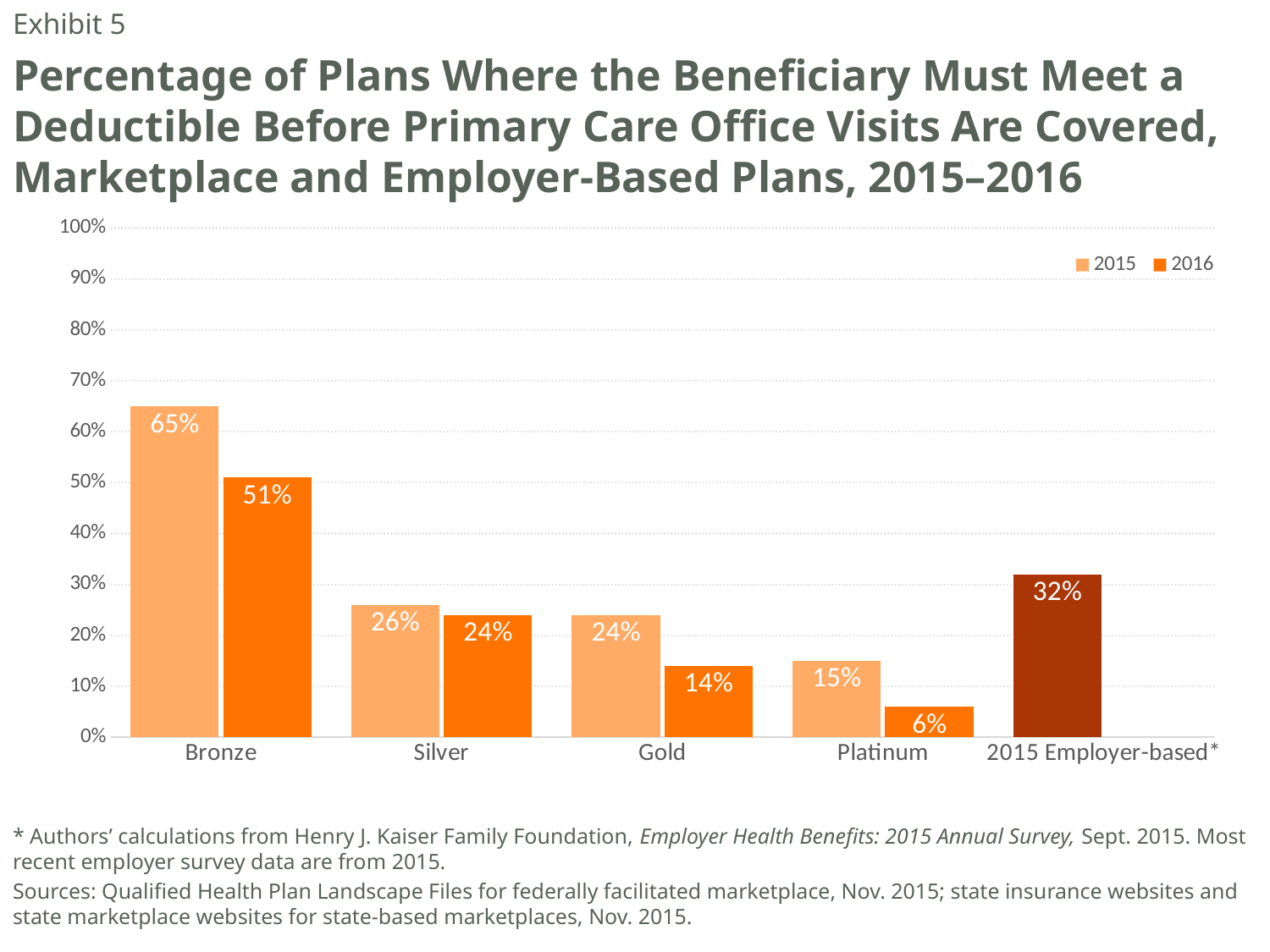
How many categories are shown on the x axis? 5 Which is larger: the 2016 value for Silver or the 2016 value for Gold? Silver Which metal tier has the highest 2016 value? Bronze What is the 2016 value for Platinum plans? 6% What is the 2015 value for Bronze plans? 65% What kind of chart is shown on the slide? Bar chart Do the 2016 values rise or fall from Bronze to Platinum? Fall Which metal tier has the lowest 2015 value? Platinum What is the value shown for 2015 Employer-based plans? 32% What is the difference between the 2015 and 2016 values for Bronze plans? 14% How many series does the legend list? 2 What is the difference between the 2015 and 2016 values for Gold plans? 10%